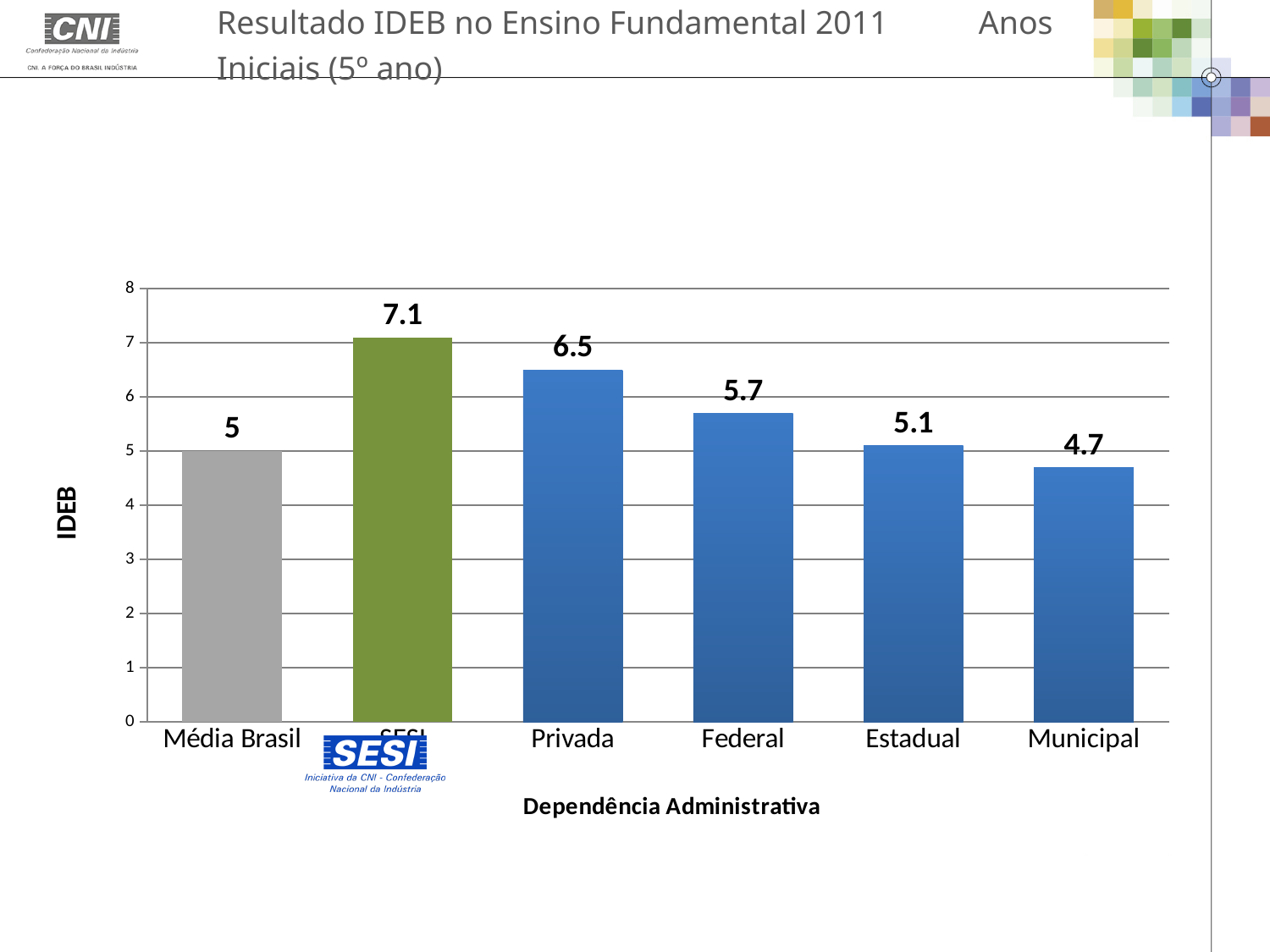
What is the label of the x axis? Dependência Administrativa What is the difference between the IDEB values for SESI and Privada? 0.6 What is the IDEB value for Municipal? 4.7 Which category has the highest IDEB value? SESI How many categories are shown on the x axis? 6 Which category has the lowest IDEB value? Municipal Which has a higher IDEB value, Federal or Estadual? Federal What is the difference between the IDEB values for Federal and Municipal? 1 Is the value for Estadual greater or less than 6? less What is the IDEB value for Privada? 6.5 What is the IDEB value for Média Brasil? 5 What kind of chart is shown on the slide? bar chart